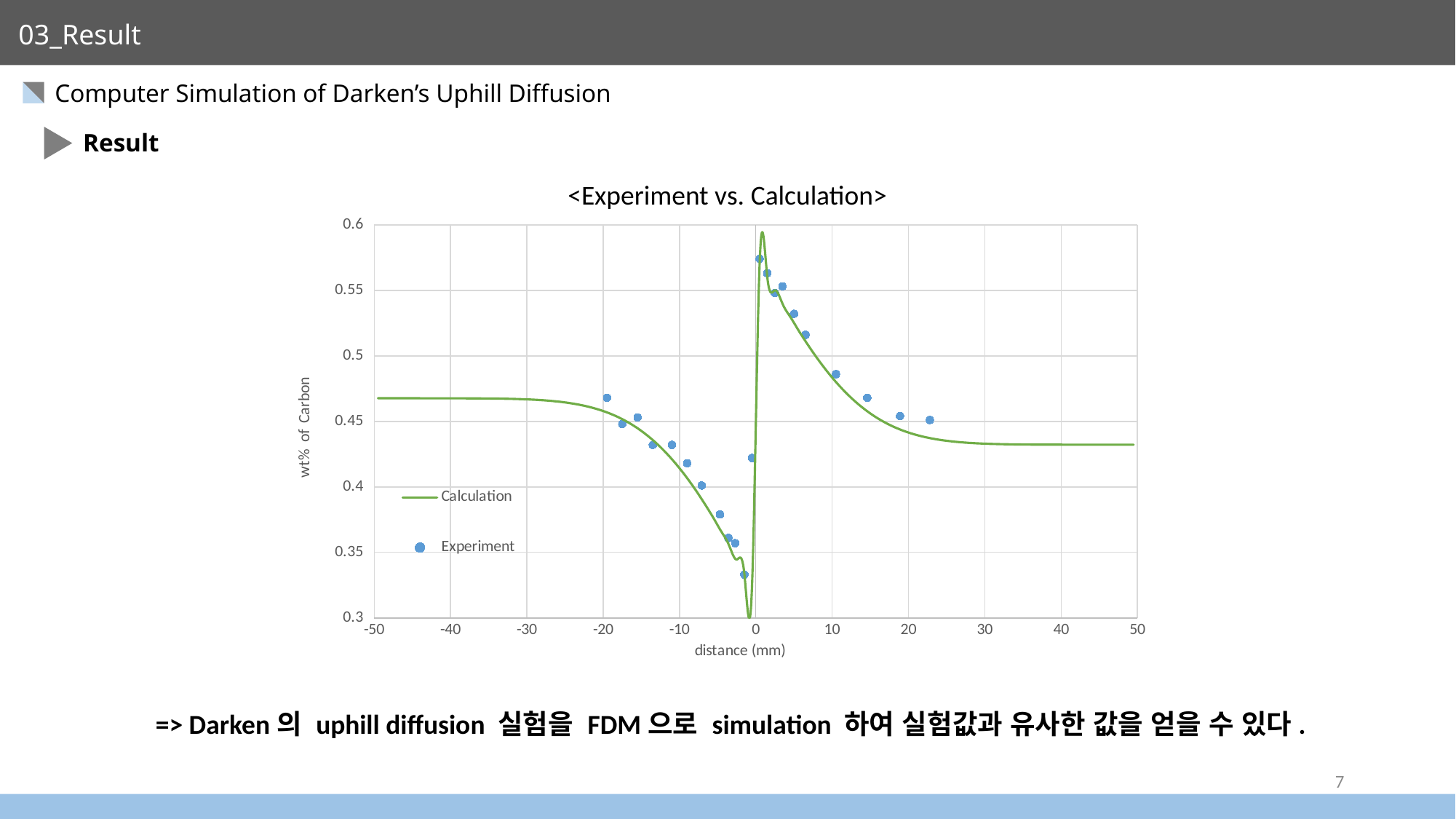
Between 10 mm and 50 mm, does the Calculation curve rise or fall? fall How many series does the legend list? 2 Which is larger, the Calculation value at -50 mm or at 50 mm? -50 mm Is the Calculation value at a distance of 50 mm greater or less than 0.45? less Is the Experiment value at about 23 mm greater or less than 0.5? less Is the Calculation value at a distance of -50 mm greater or less than 0.45? greater What kind of chart is shown on the slide? Line chart with scatter points What is the title of the chart? <Experiment vs. Calculation> What are the two series named in the legend? Calculation and Experiment